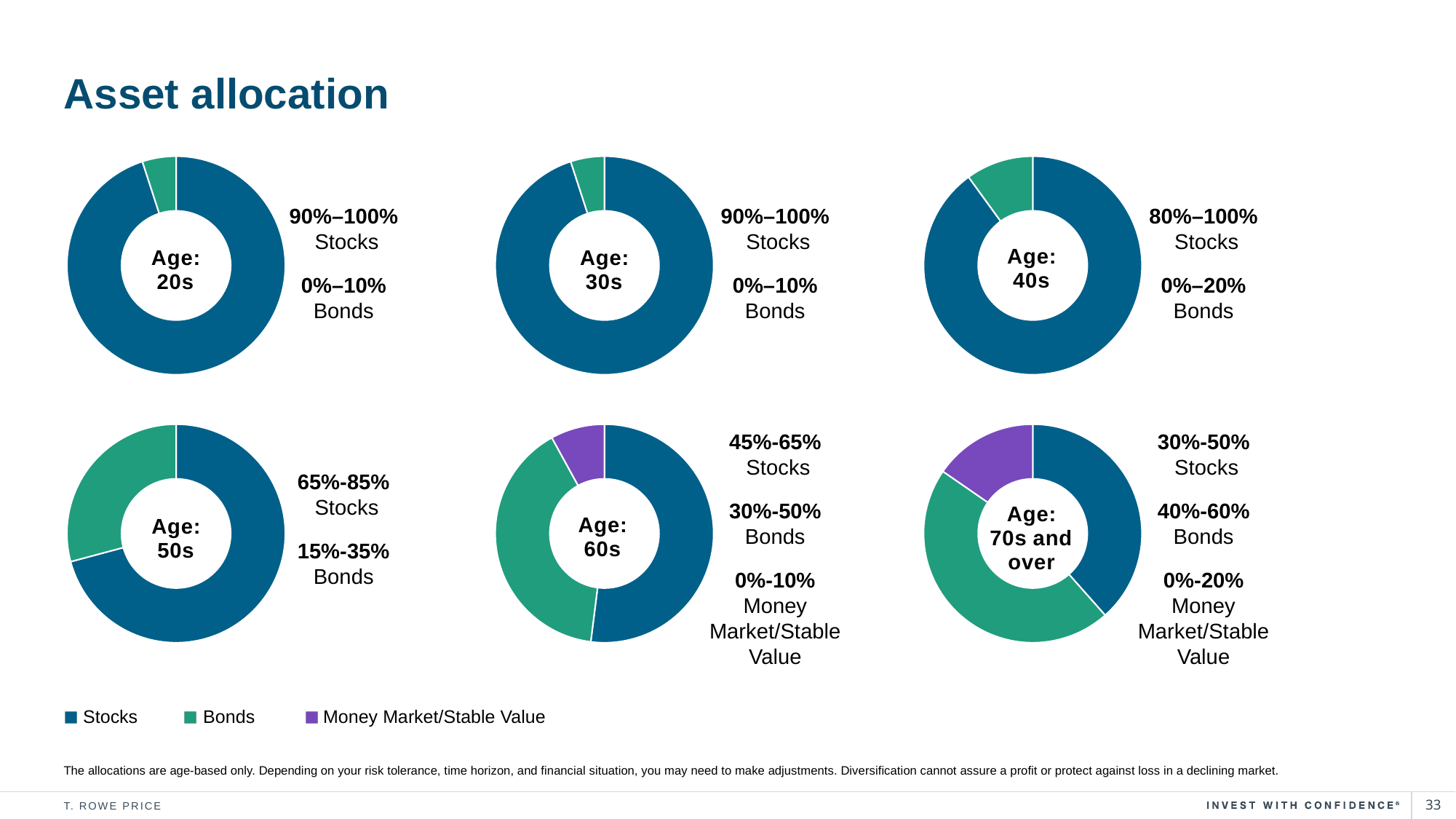
Which colour represents Money Market/Stable Value in the legend? Purple In the Age: 40s chart, what allocation range is shown for Bonds? 0%–20% In the Age: 60s chart, what allocation range is shown for Money Market/Stable Value? 0%-10% In the Age: 70s and over chart, which asset class has the largest slice? Bonds In the Age: 50s chart, what allocation range is shown for Stocks? 65%-85% What kind of chart is used for each age group on the slide? Donut (pie) chart In the Age: 70s and over chart, what allocation range is shown for Bonds? 40%-60% In the Age: 30s chart, which slice is larger, Stocks or Bonds? Stocks In the Age: 20s chart, what allocation range is shown for Stocks? 90%–100% In the Age: 60s chart, which asset class has the smallest slice? Money Market/Stable Value How many series does the legend at the bottom of the slide list? 3 How many donut charts are shown on the slide? 6